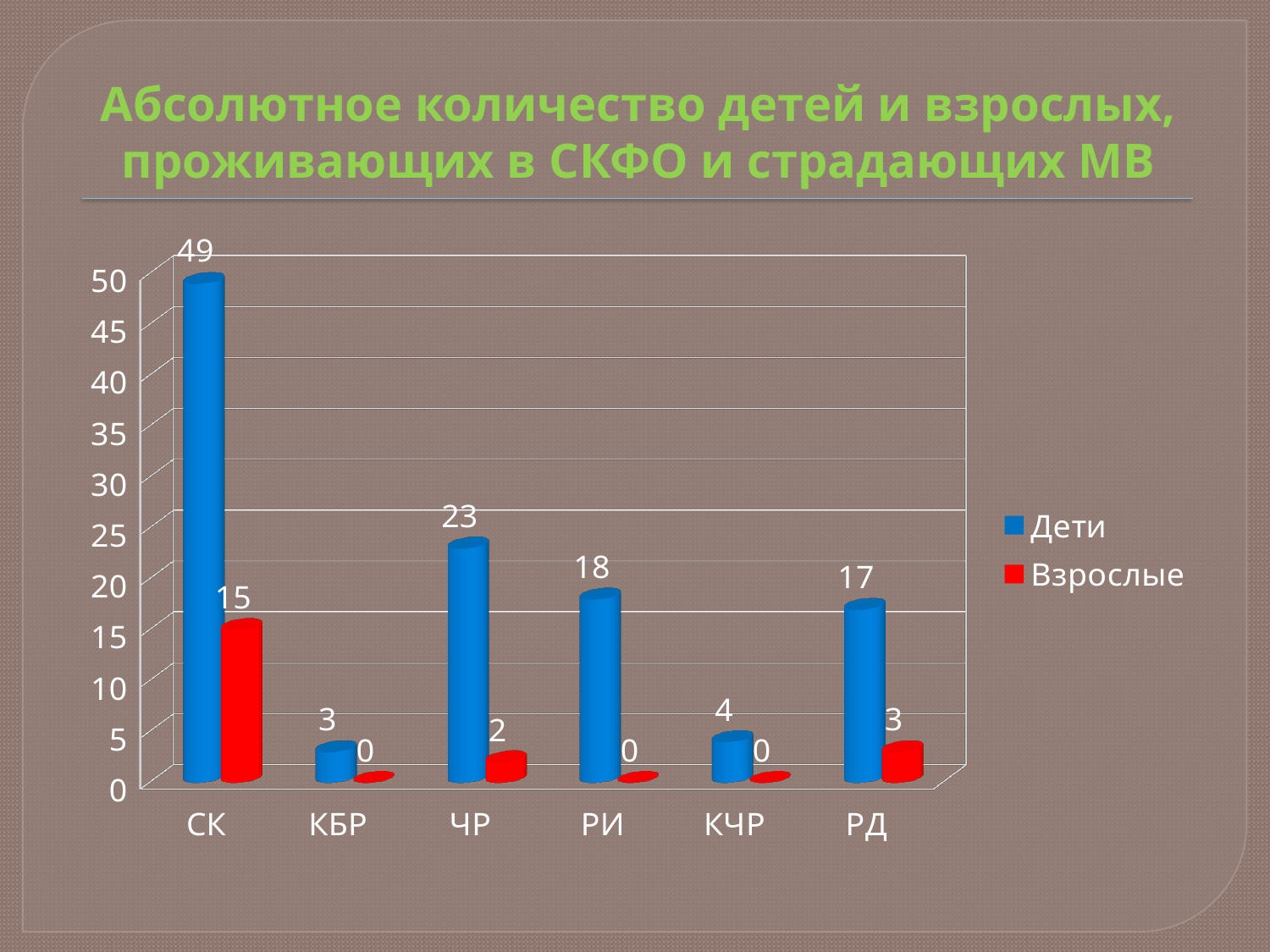
Which is larger, Дети in РИ or Дети in РД? Дети in РИ What kind of chart is shown on the slide? Bar chart What is the value for Взрослые in РД? 3 How many categories are shown on the x axis? 6 Which colour represents the Взрослые series? Red How many series does the legend list? 2 Which category has the highest value for Дети? СК What is the value for Дети in СК? 49 Which category has the lowest value for Дети? КБР What is the difference between Дети and Взрослые in СК? 34 What is the value for Дети in ЧР? 23 What is the value for Взрослые in СК? 15